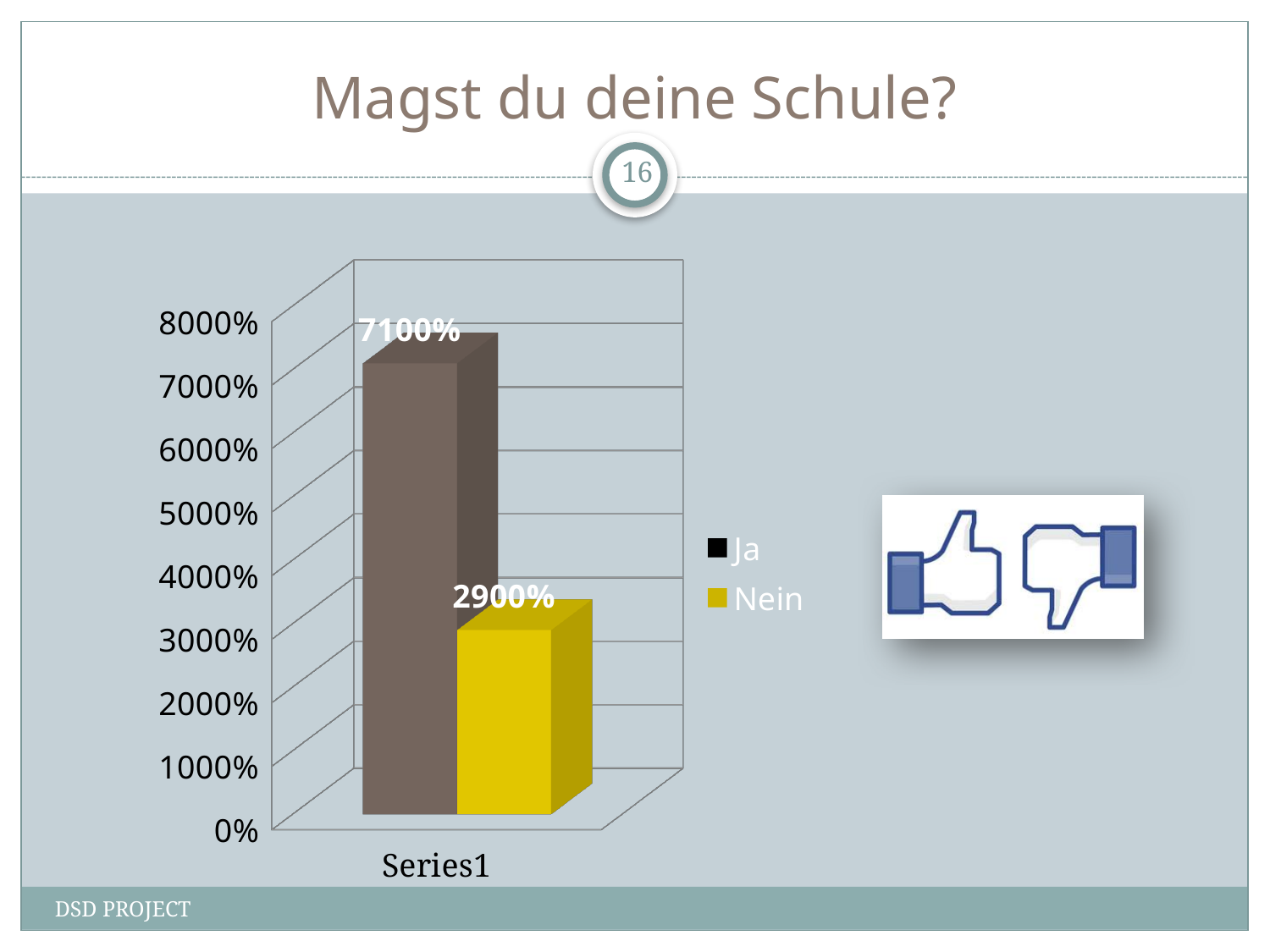
What is the difference between the values for Ja and Nein? 4200% What kind of chart is shown on the slide? bar chart What colour is the bar for Nein? yellow What is the value for Ja? 7100% Which series has the lowest value? Nein Which is larger, the value for Ja or the value for Nein? Ja Is the value for Ja greater or less than 7000%? greater What is the title of the slide containing the chart? Magst du deine Schule? Which series has the highest value? Ja Is the value for Nein greater or less than 3000%? less What is the value for Nein? 2900% How many series does the legend list? 2